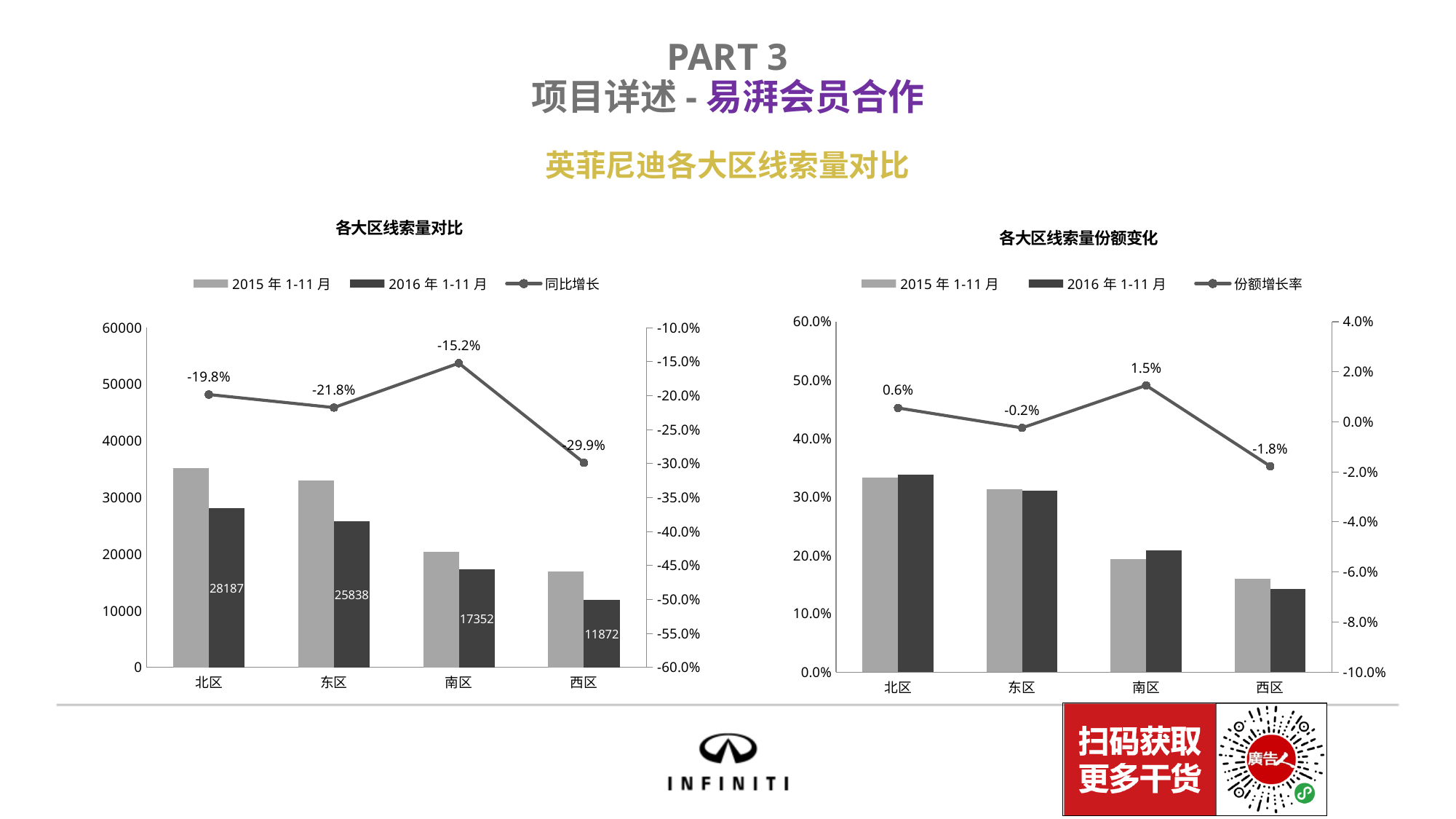
In the chart titled 各大区线索量对比, what is the 同比增长 value for 南区? -15.2% How many regions are shown on the x axis of the chart titled 各大区线索量份额变化? 4 In the chart titled 各大区线索量对比, which region has the highest 2016 年 1-11 月 value? 北区 In the chart titled 各大区线索量对比, which region has the lowest 同比增长? 西区 In the chart titled 各大区线索量对比, what is the difference between the 2016 年 1-11 月 values for 北区 and 东区? 2349 In the chart titled 各大区线索量对比, is the 2015 年 1-11 月 value for 北区 greater or less than 30000? greater In the chart titled 各大区线索量对比, is the 2016 年 1-11 月 value larger for 南区 or 西区? 南区 In the chart titled 各大区线索量对比, what is the 2016 年 1-11 月 value for 北区? 28187 In the chart titled 各大区线索量对比, do the 2016 年 1-11 月 bars rise or fall from 北区 to 西区? fall In the chart titled 各大区线索量份额变化, is the 2015 年 1-11 月 value for 西区 greater or less than 20.0%? less In the chart titled 各大区线索量份额变化, what is the 份额增长率 value for 南区? 1.5% How many series does the legend of the chart titled 各大区线索量份额变化 list? 3